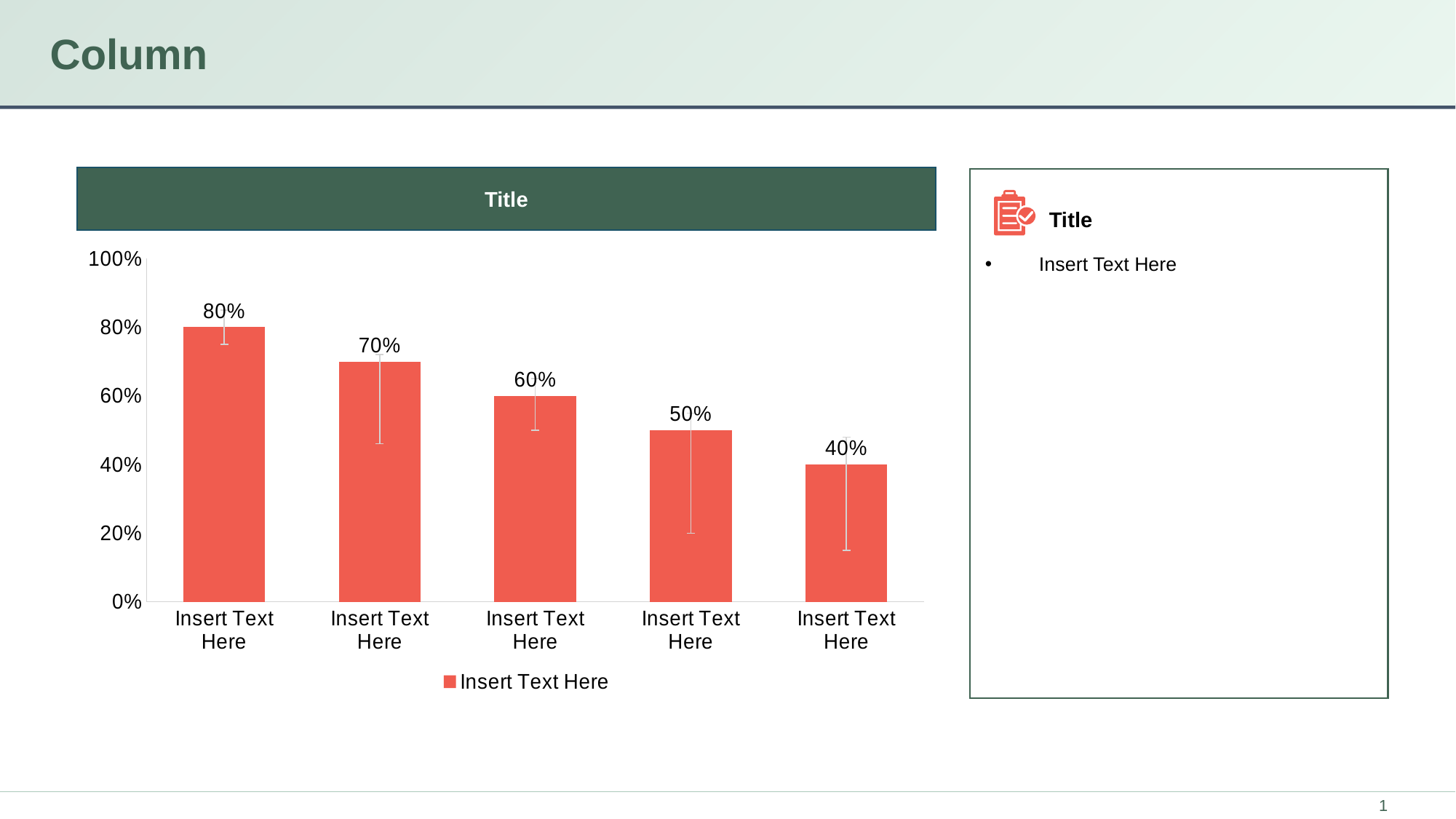
What is the value of the last (rightmost) bar in the chart? 40% Which is larger, the second bar or the fourth bar? The second bar (70%) How many series does the legend list? 1 What is the difference between the second bar and the fourth bar in the chart? 20% Which bar has the lowest value in the chart? The last (rightmost) bar, 40% How many bars are plotted in the chart? 5 Do the bar values rise or fall from left to right along the x axis? Fall What is the difference between the first bar (80%) and the last bar (40%)? 40% What is the value of the first (leftmost) bar in the chart? 80% What type of chart is shown on the slide? Bar chart What is the value of the third bar from the left in the chart? 60% Which bar has the highest value in the chart? The first (leftmost) bar, 80%